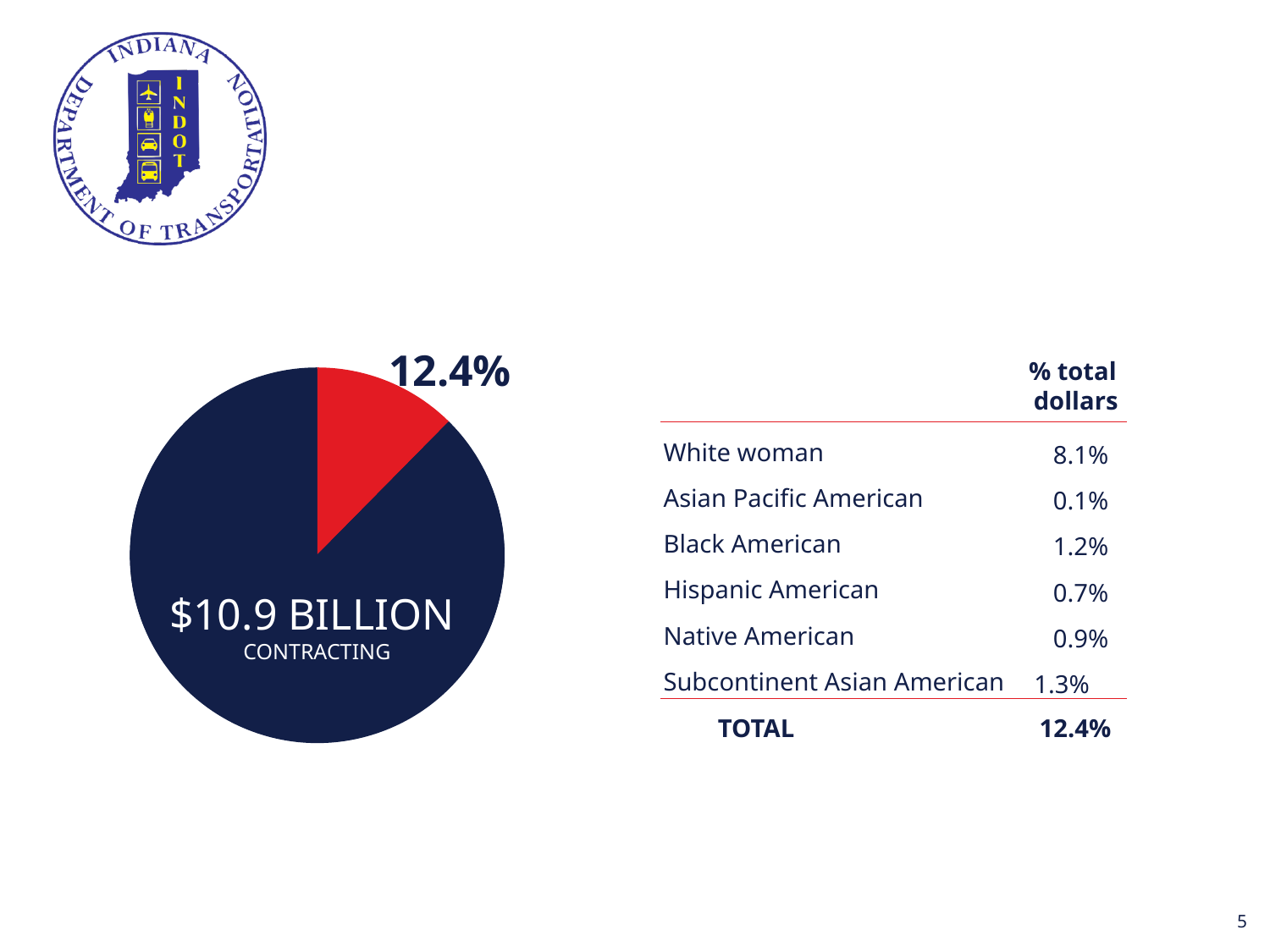
According to the table next to the pie chart, what is the difference between the % total dollars for Black American and Hispanic American? 0.5% According to the table next to the pie chart, what is the TOTAL % total dollars? 12.4% According to the table next to the pie chart, what is the % total dollars for White woman? 8.1% Is the share of the red slice greater or less than 50%? less How many slices does the pie chart have? 2 What dollar amount is printed in the centre of the pie chart? $10.9 BILLION Which slice of the pie is larger, the red slice or the dark navy slice? the dark navy slice What share of the pie does the red slice represent? 12.4% According to the table next to the pie chart, which group has the lowest % total dollars? Asian Pacific American What kind of chart is shown on the slide? pie chart What word appears below the dollar amount in the centre of the pie chart? CONTRACTING According to the table next to the pie chart, which group has the highest % total dollars? White woman